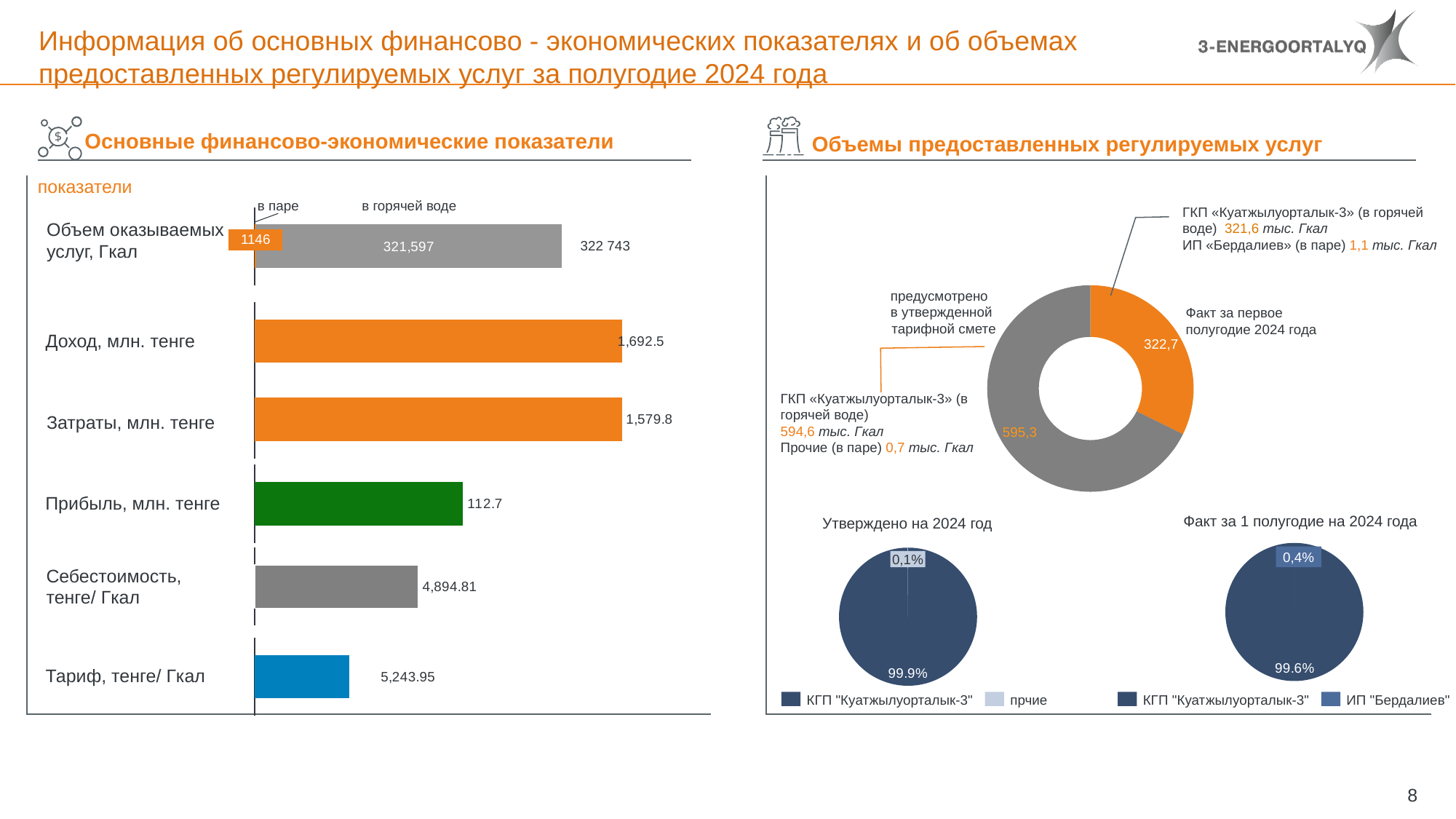
What kind of chart is the chart under 'Основные финансово-экономические показатели'? bar chart In the bar chart 'Основные финансово-экономические показатели', what is the value for 'Доход, млн. тенге'? 1,692.5 In the bar chart 'Основные финансово-экономические показатели', what is the value for 'Прибыль, млн. тенге'? 112.7 In the bar chart 'Основные финансово-экономические показатели', what is the value for 'Тариф, тенге/ Гкал'? 5,243.95 In the bar chart 'Основные финансово-экономические показатели', which is larger: 'Тариф, тенге/ Гкал' or 'Себестоимость, тенге/ Гкал'? Тариф, тенге/ Гкал In the bar chart 'Основные финансово-экономические показатели', what is the difference between 'Доход, млн. тенге' and 'Затраты, млн. тенге'? 112.7 In the bar chart 'Основные финансово-экономические показатели', what is the value for 'Затраты, млн. тенге'? 1,579.8 In the pie chart 'Факт за 1 полугодие на 2024 года', what share does 'ИП "Бердалиев"' have? 0,4% In the pie chart 'Утверждено на 2024 год', what share does 'КГП "Куатжылуорталык-3"' have? 99.9% In the donut chart under 'Объемы предоставленных регулируемых услуг', what is the value for 'Факт за первое полугодие 2024 года'? 322,7 In the donut chart under 'Объемы предоставленных регулируемых услуг', what is the value for 'предусмотрено в утвержденной тарифной смете'? 595,3 In the bar chart 'Основные финансово-экономические показатели', what is the value labelled 'в горячей воде' for 'Объем оказываемых услуг, Гкал'? 321,597